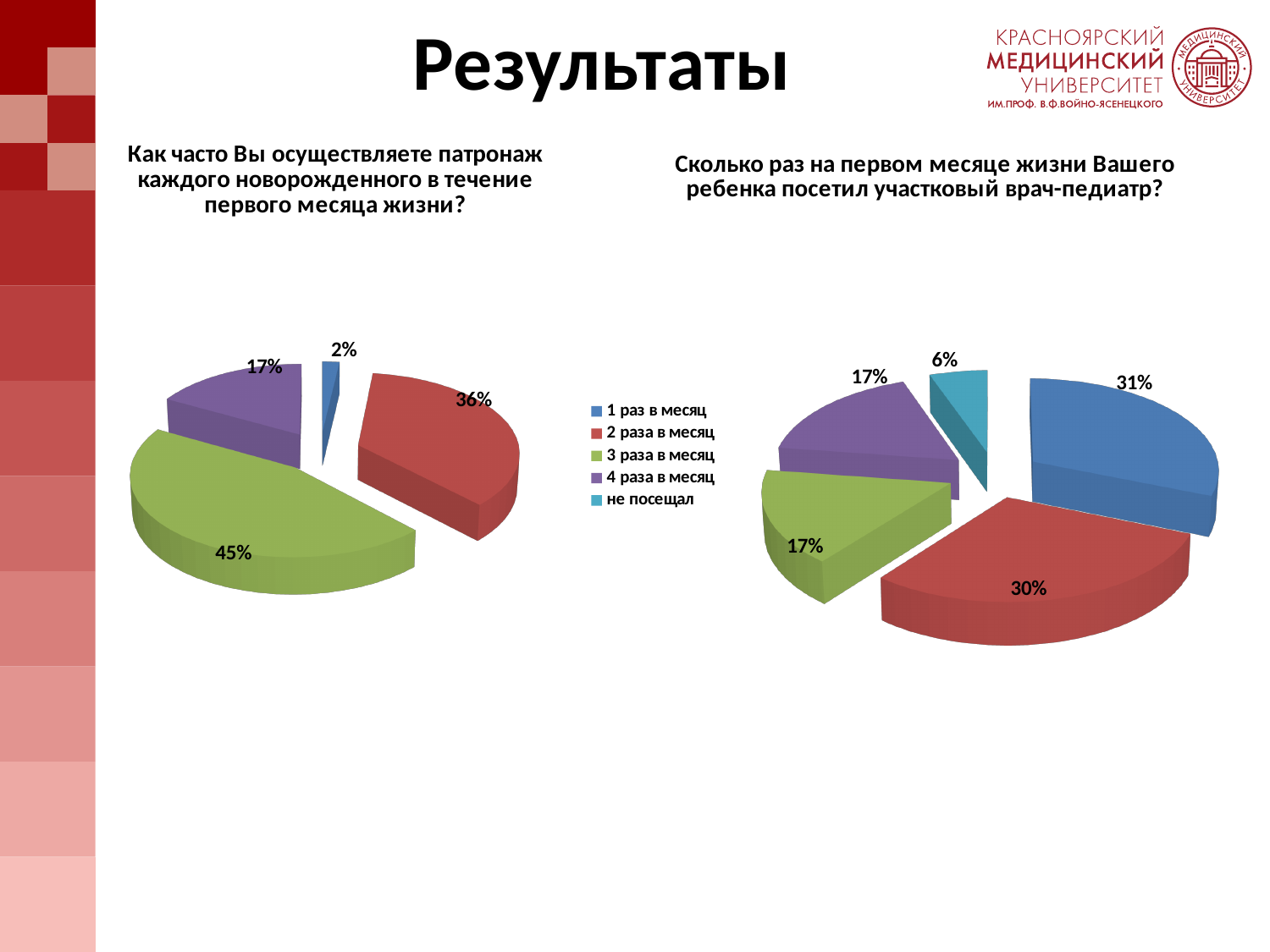
In the right chart ("Сколько раз на первом месяце жизни..."), which category has the smallest slice? не посещал In the left chart ("Как часто Вы осуществляете патронаж..."), what share is shown for "1 раз в месяц"? 2% In the left chart ("Как часто Вы осуществляете патронаж..."), which category has the largest slice? 3 раза в месяц What type of chart is used on the left of the slide ("Как часто Вы осуществляете патронаж...")? pie chart In the right chart ("Сколько раз на первом месяце жизни..."), what is the difference between the shares for "2 раза в месяц" and "3 раза в месяц"? 13% In the right chart ("Сколько раз на первом месяце жизни..."), what share is shown for "не посещал"? 6% Which colour represents "4 раза в месяц" in the legend? purple In the left chart ("Как часто Вы осуществляете патронаж..."), which category has the smallest slice? 1 раз в месяц In the left chart ("Как часто Вы осуществляете патронаж..."), what share is shown for "3 раза в месяц"? 45% In the left chart ("Как часто Вы осуществляете патронаж..."), what is the difference between the shares for "3 раза в месяц" and "2 раза в месяц"? 9% In the right chart ("Сколько раз на первом месяце жизни..."), what share is shown for "1 раз в месяц"? 31% How many entries does the legend between the two charts list? 5